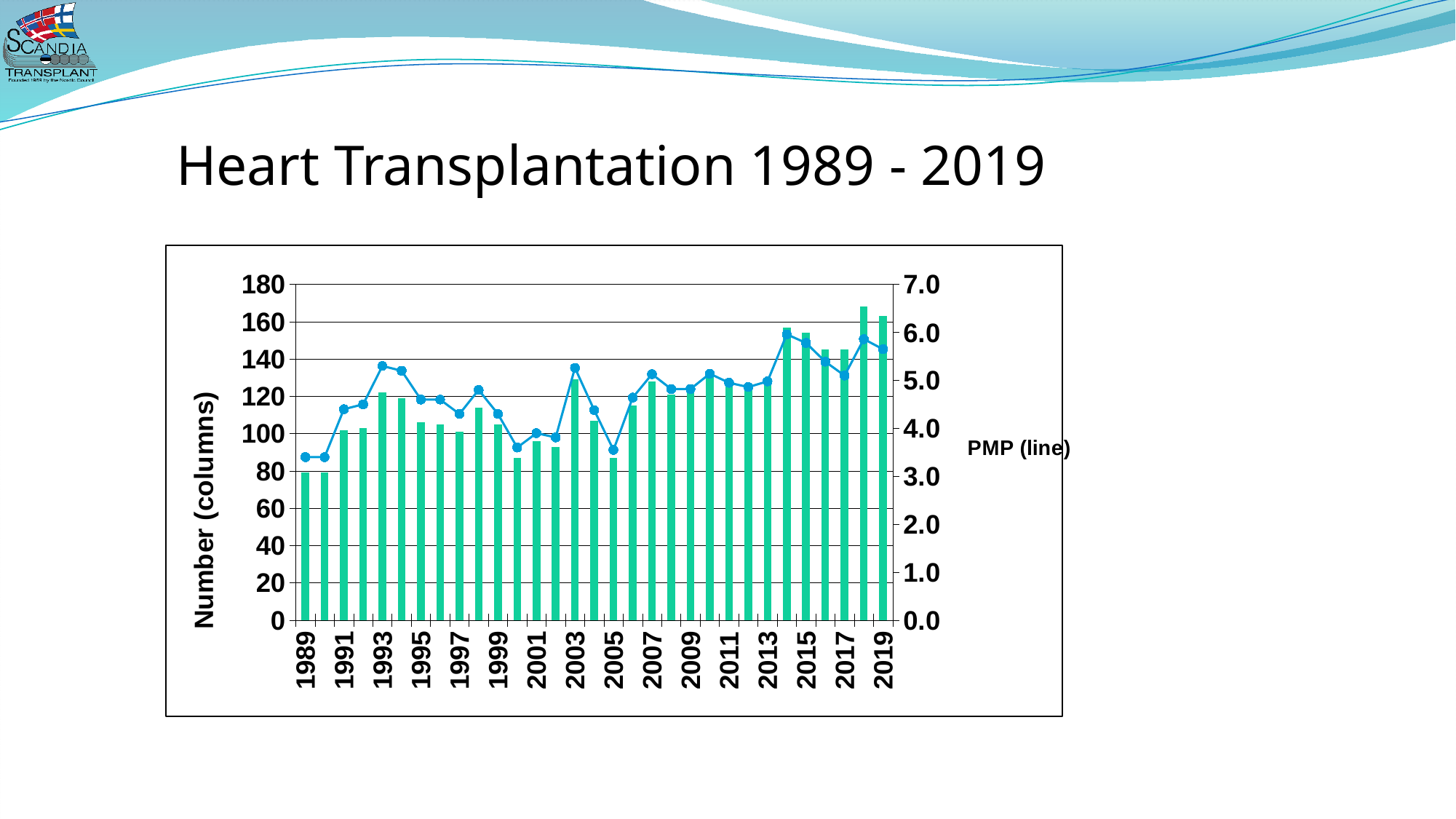
Is the bar value for 2018 greater or less than 160? greater What is the label of the left vertical axis? Number (columns) Which year has a taller bar, 2018 or 2005? 2018 Is the bar value for 2014 greater or less than 140? greater Is the line (PMP) value for 1989 greater or less than 4.0? less What kind of chart is shown on the slide? A combined bar and line chart How many years are plotted along the x axis of the chart? 31 Do the bar values rise or fall from 2013 to 2014? rise Which year has a higher line (PMP) value, 2014 or 1989? 2014 Which year has the tallest bar in the chart? 2018